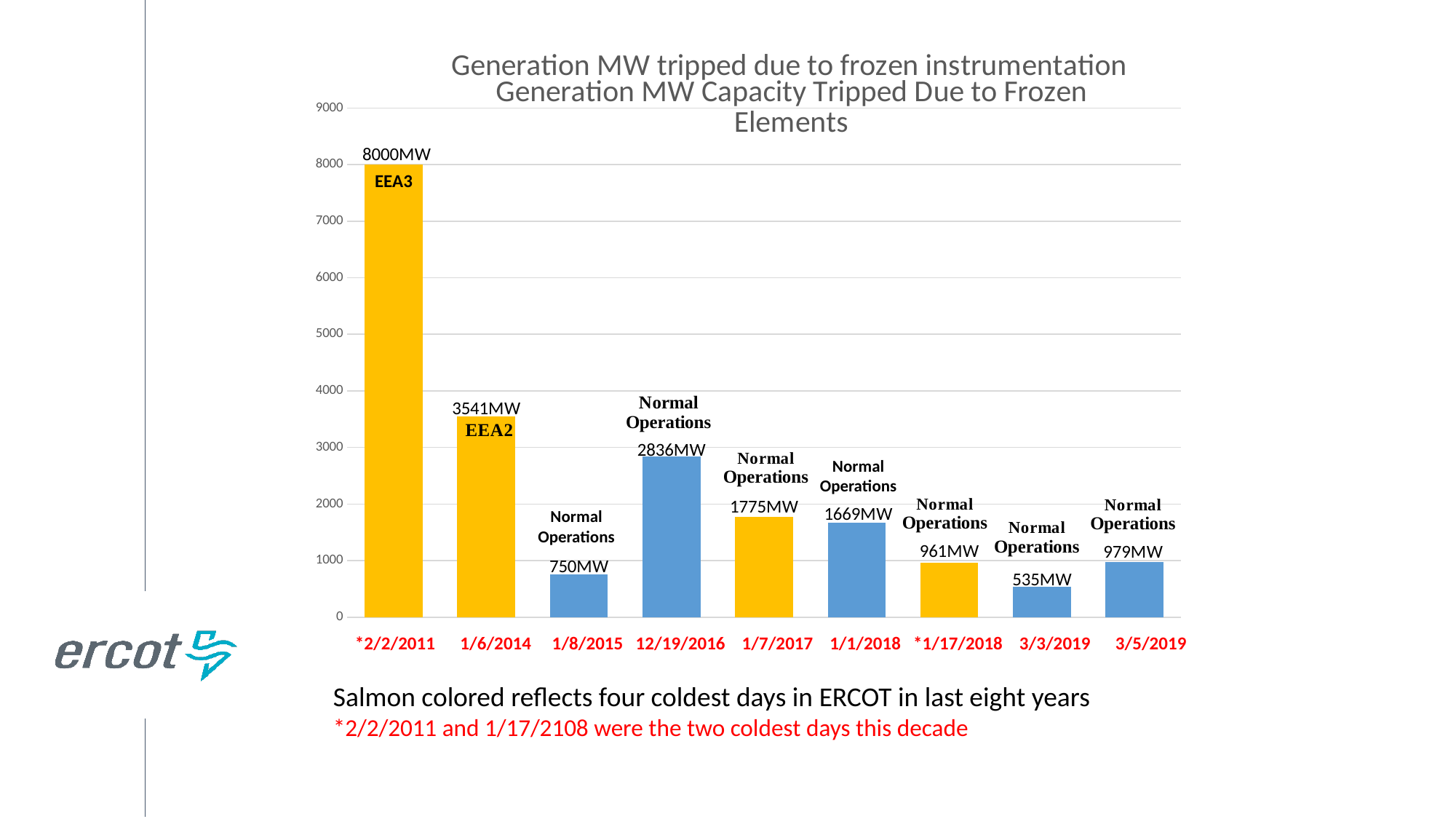
What label is printed on the bar for 1/6/2014? EEA2 What is the difference between the values for 1/6/2014 and 12/19/2016? 705MW What value is shown for 2/2/2011? 8000MW What value is shown for 12/19/2016? 2836MW What kind of chart is shown on the slide? bar chart Which date has the lowest generation MW tripped? 3/3/2019 Is the value for 1/8/2015 greater or less than 1000? less What is the difference between the values for 3/5/2019 and 3/3/2019? 444MW Which is larger, the value for 1/7/2017 or the value for 1/1/2018? 1/7/2017 What value is shown for 3/3/2019? 535MW Which date has the highest generation MW tripped? 2/2/2011 How many dates are shown on the x axis? 9